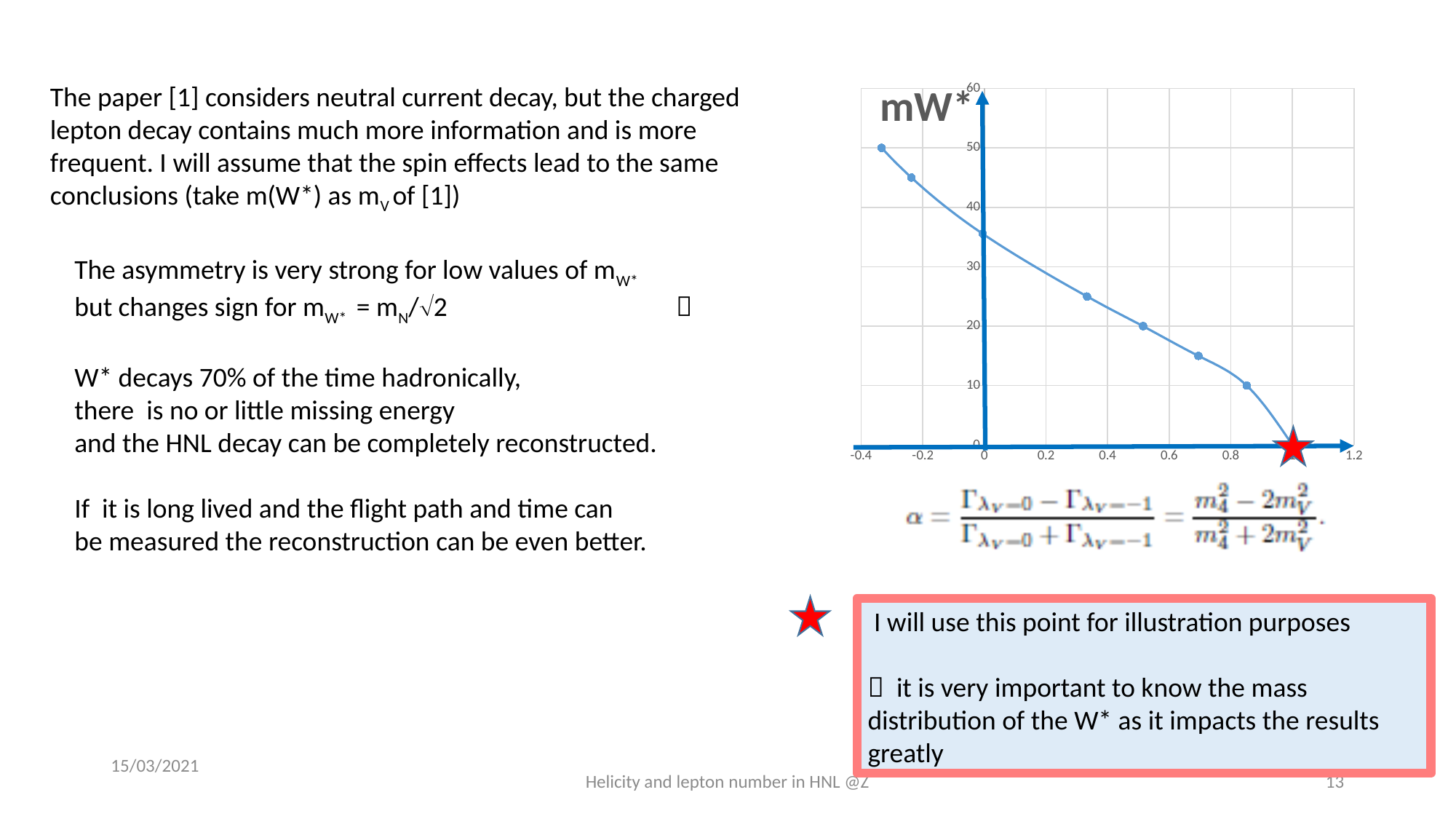
What is the highest value shown on the x axis of the chart? 1.2 What label is written on the vertical axis of the chart? mW* Do the plotted values rise or fall as the x value increases? fall Which data point has the highest y value, the leftmost or the rightmost? leftmost Which data point has the lowest y value on the chart? the rightmost point (marked with the red star) Is the y value of the data point near x = 0.7 greater or less than 20? less What is the y value of the data point marked with the red star? 0 What kind of chart is shown on the slide? line chart Is the y value of the second data point from the left greater or less than 40? greater What is the y value of the leftmost data point on the chart? 50 How many data points are plotted on the chart? 8 Is the y value of the data point near x = 0.4 greater or less than 30? less